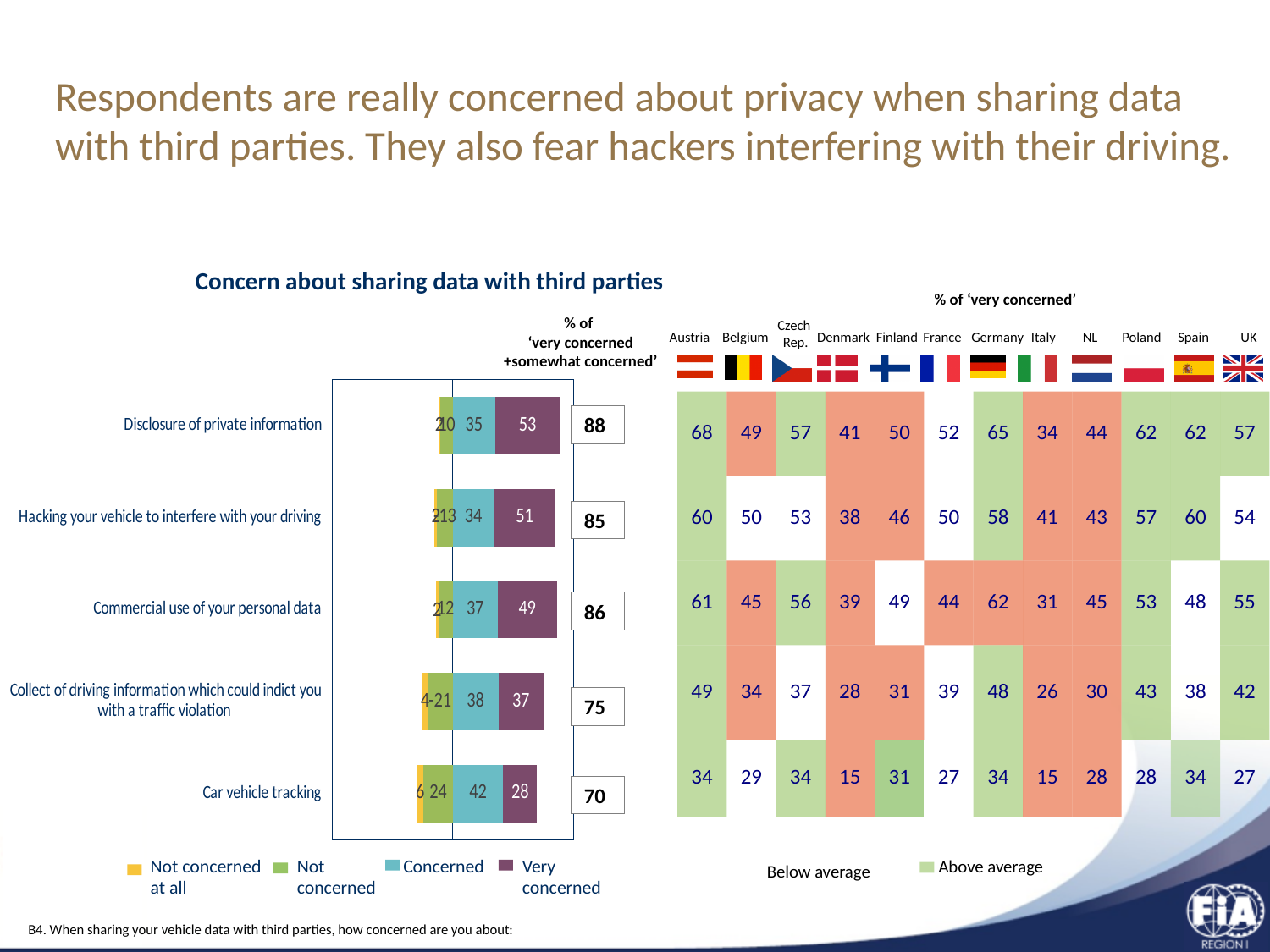
How many categories are shown in the 'Concern about sharing data with third parties' chart? 5 In the 'Concern about sharing data with third parties' chart, what is the 'Concerned' value for 'Car vehicle tracking'? 42 In the '% of very concerned' table on the right, what is the value for Austria for 'Disclosure of private information'? 68 In the 'Concern about sharing data with third parties' chart, which is larger: the 'Concerned' value for 'Car vehicle tracking' or for 'Disclosure of private information'? Car vehicle tracking In the 'Concern about sharing data with third parties' chart, which category has the highest 'Very concerned' value? Disclosure of private information What type of chart is 'Concern about sharing data with third parties'? Stacked bar chart In the 'Concern about sharing data with third parties' chart, what is the difference between the 'Very concerned' values for 'Disclosure of private information' and 'Car vehicle tracking'? 25 In the 'Concern about sharing data with third parties' chart, what is the '% of very concerned + somewhat concerned' for 'Commercial use of your personal data'? 86 In the 'Concern about sharing data with third parties' chart, what is the 'Very concerned' value for 'Hacking your vehicle to interfere with your driving'? 51 In the 'Concern about sharing data with third parties' chart, what is the 'Very concerned' value for 'Disclosure of private information'? 53 In the 'Concern about sharing data with third parties' chart, which category has the lowest 'Very concerned' value? Car vehicle tracking How many series does the legend of the 'Concern about sharing data with third parties' chart list? 4